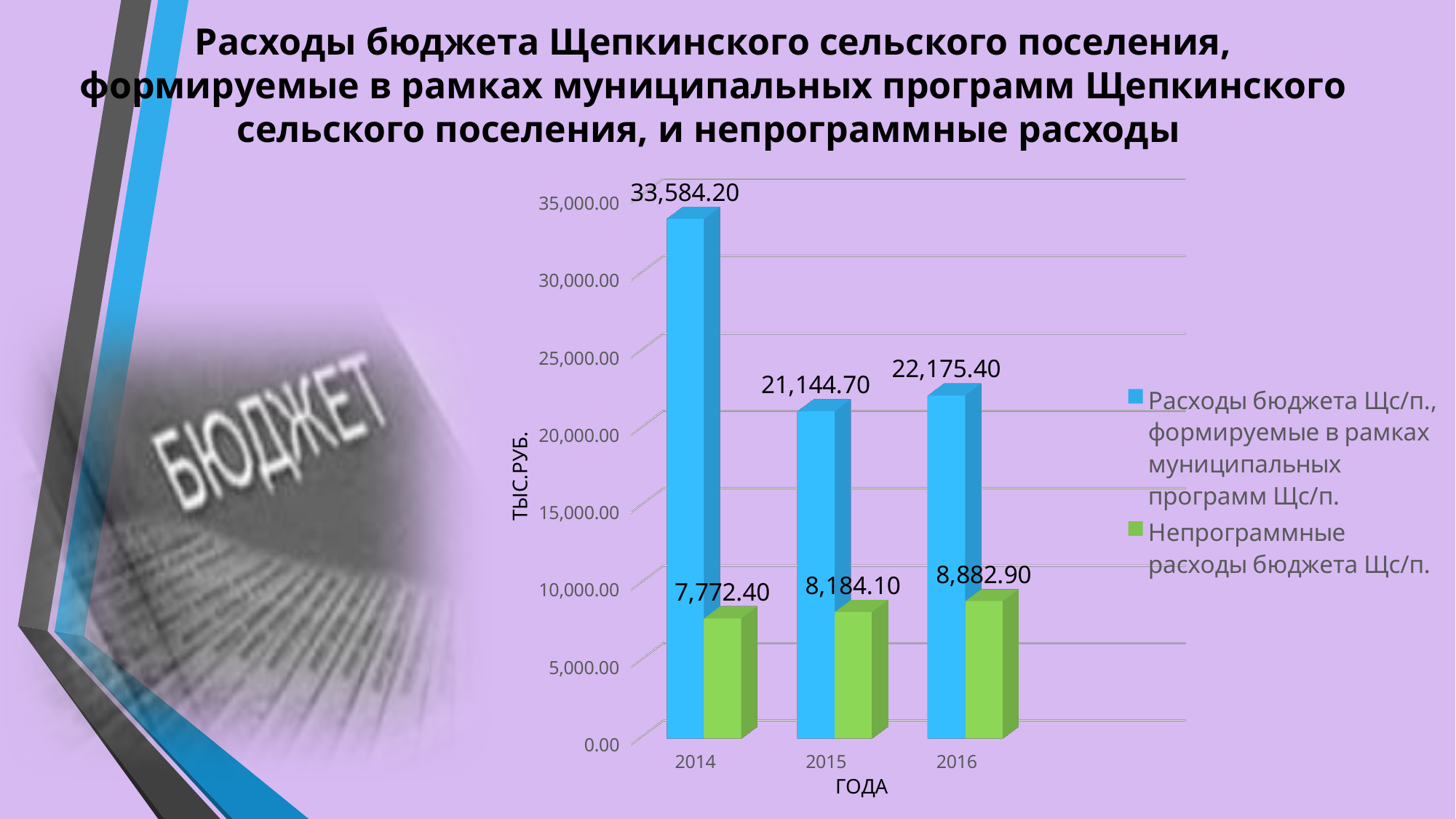
What is the value for 2014 in the series "Расходы бюджета Щс/п., формируемые в рамках муниципальных программ Щс/п."? 33,584.20 How many years are shown on the x axis? 3 Which is larger in the series "Расходы бюджета Щс/п., формируемые в рамках муниципальных программ Щс/п.": 2015 or 2016? 2016 Which year has the highest value in the series "Расходы бюджета Щс/п., формируемые в рамках муниципальных программ Щс/п."? 2014 What is the value for 2015 in the series "Расходы бюджета Щс/п., формируемые в рамках муниципальных программ Щс/п."? 21,144.70 How many series does the legend list? 2 What is the difference between the two series' values in 2014? 25,811.80 Do the values in the series "Непрограммные расходы бюджета Щс/п." rise or fall from 2014 to 2016? Rise Which year has the lowest value in the series "Непрограммные расходы бюджета Щс/п."? 2014 By how much does the value for 2016 exceed the value for 2015 in the series "Непрограммные расходы бюджета Щс/п."? 698.80 What kind of chart is shown on the slide? Bar chart What is the value for 2016 in the series "Непрограммные расходы бюджета Щс/п."? 8,882.90